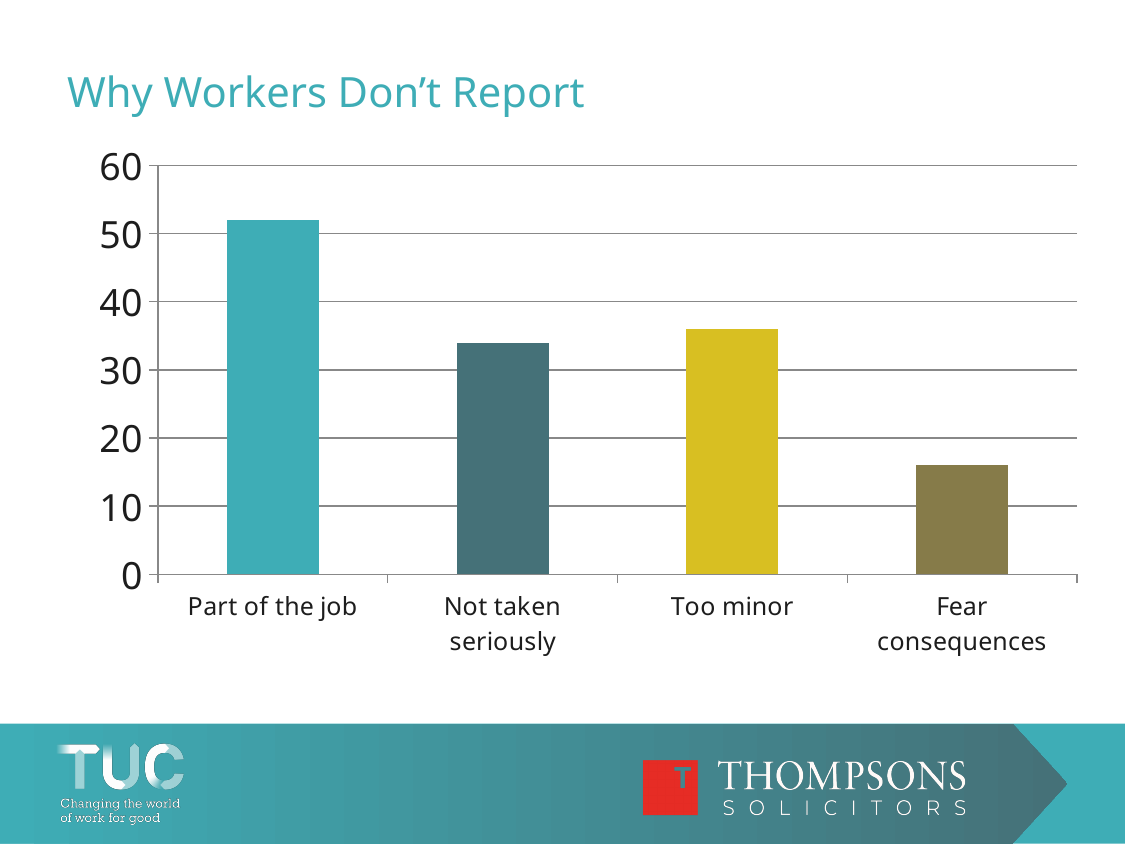
Which category has the lowest bar? Fear consequences Is the value for Too minor greater or less than 40? less How many categories are shown on the x axis? 4 Is the value for Fear consequences greater or less than 10? greater Is the value for Part of the job greater or less than 40? greater Which is larger, the value for Part of the job or the value for Too minor? Part of the job What is the title of the chart? Why Workers Don't Report What kind of chart is shown on the slide? bar chart Which category has the highest bar? Part of the job Which is larger, the value for Not taken seriously or the value for Fear consequences? Not taken seriously